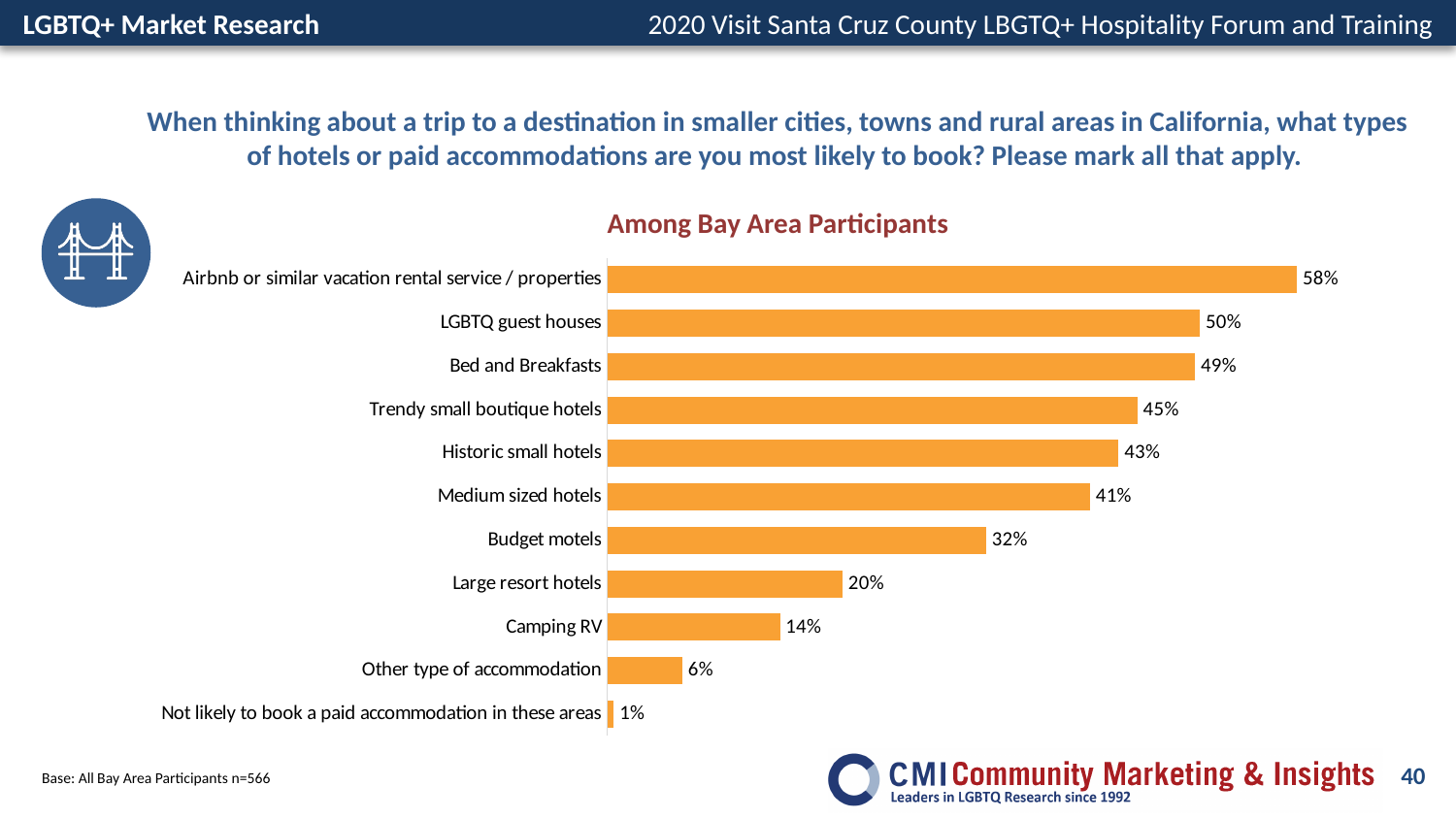
What is the difference in percentage points between LGBTQ guest houses and Large resort hotels? 30 What percentage is shown for Camping RV? 14% What percentage of Bay Area participants said they are most likely to book Airbnb or similar vacation rental service / properties? 58% Which has a higher value: Historic small hotels or Budget motels? Historic small hotels Which accommodation type has the highest percentage on the chart? Airbnb or similar vacation rental service / properties How many accommodation categories are shown on the chart? 11 What is the value shown for Budget motels? 32% What type of chart is used on this slide? Bar chart What is the difference between the values for Trendy small boutique hotels and Medium sized hotels? 4 Which is larger: Bed and Breakfasts or Other type of accommodation? Bed and Breakfasts What is the title of the chart? Among Bay Area Participants Which category has the lowest percentage on the chart? Not likely to book a paid accommodation in these areas